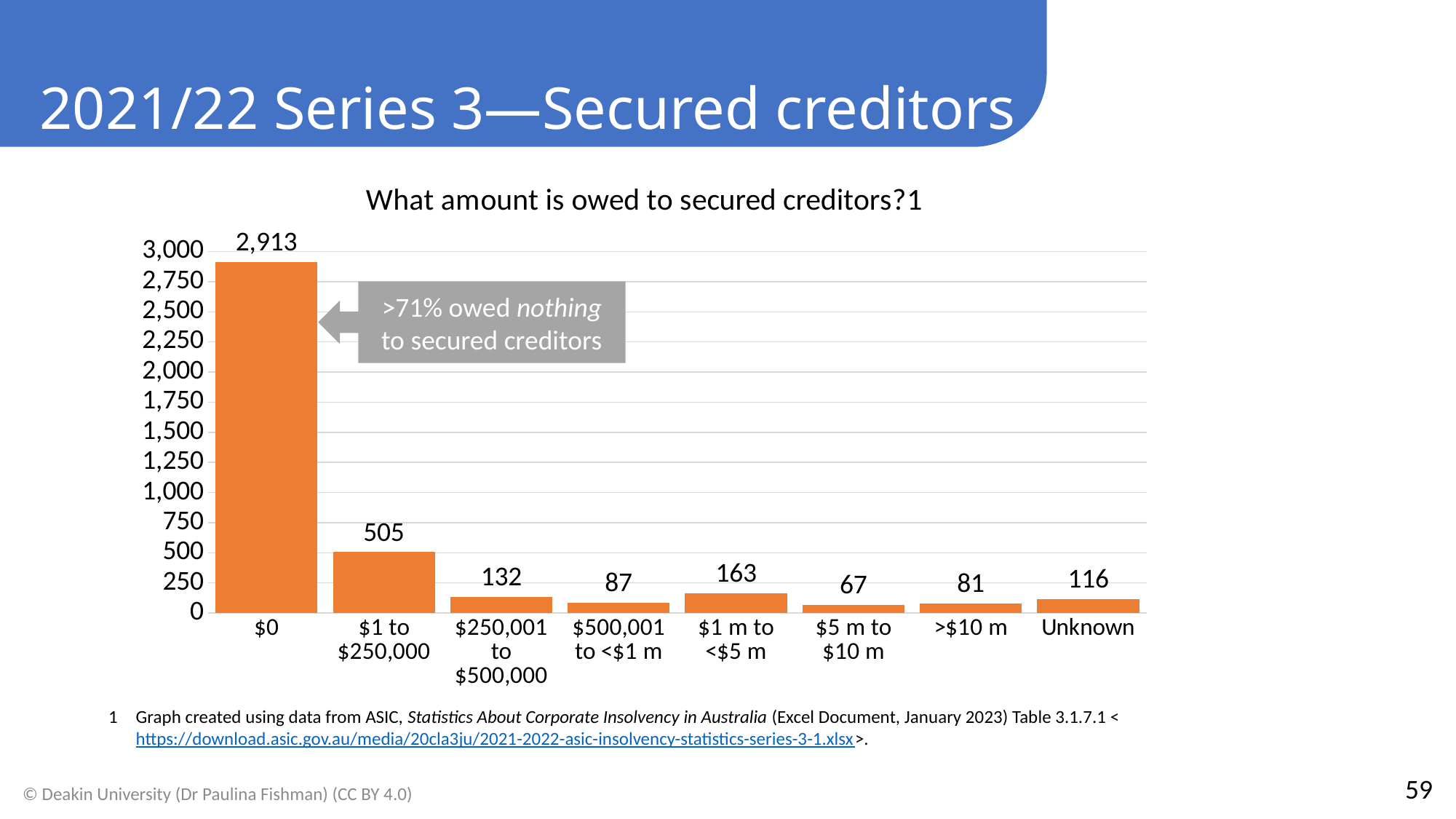
What is the value for the $0 category? 2,913 Is the value for $1 to $250,000 greater or less than 750? less How many categories are shown on the x axis? 8 Which category has the highest value? $0 Which is larger, the value for $250,001 to $500,000 or the value for $500,001 to <$1 m? $250,001 to $500,000 What kind of chart is shown on the slide? bar chart What is the difference between the values for $0 and $1 to $250,000? 2,408 Which category has the lowest value? $5 m to $10 m What is the value for the Unknown category? 116 What is the value for the $1 to $250,000 category? 505 What is the title of the chart? What amount is owed to secured creditors? What is the value for the $1 m to <$5 m category? 163